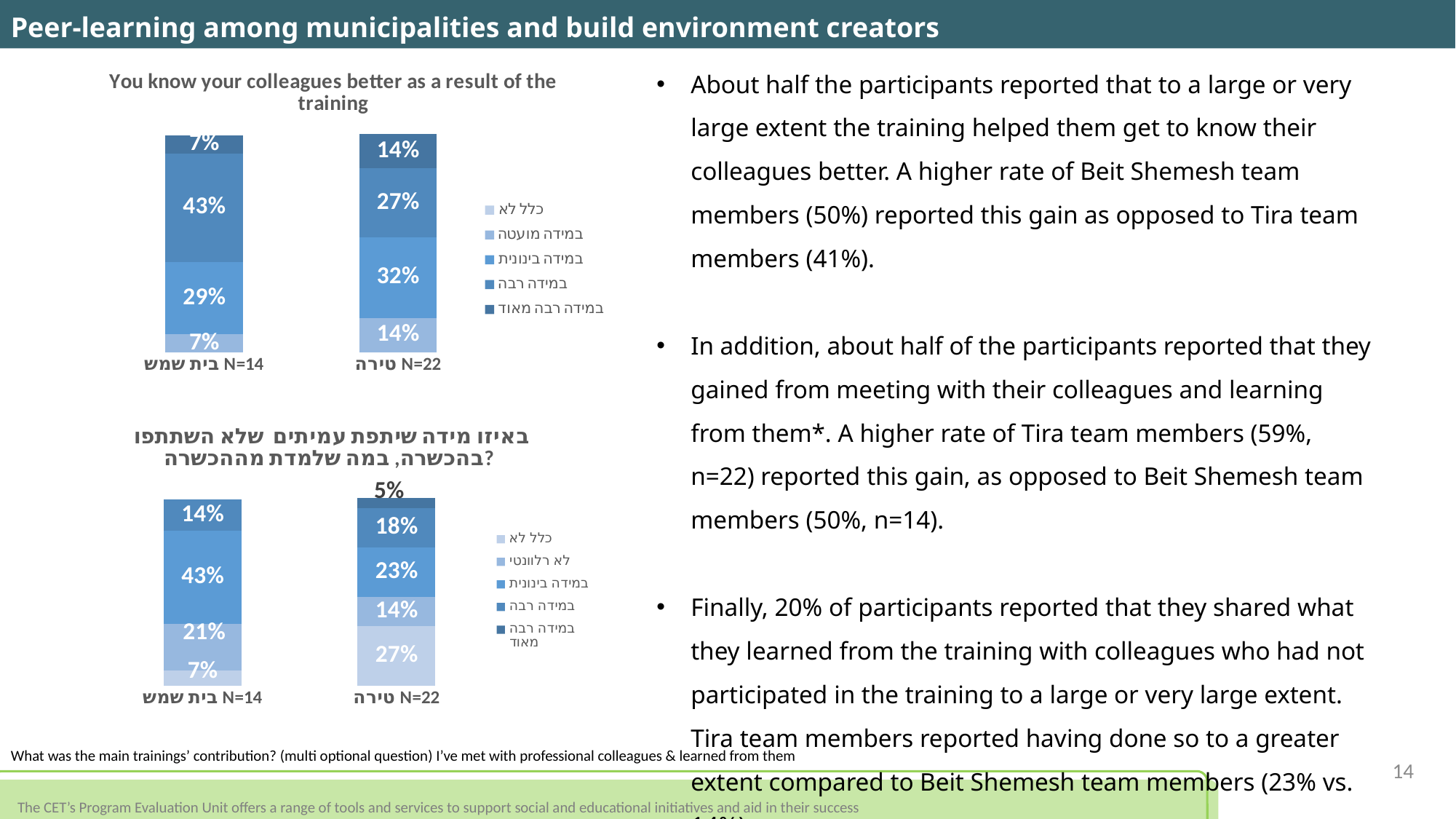
In the bottom chart (sharing what was learned with colleagues), what is the value of the topmost segment of the טירה bar? 5% In the bottom chart (sharing what was learned with colleagues), what is the value of the bottom segment of the טירה bar? 27% What type of chart is the top chart titled 'You know your colleagues better as a result of the training'? Stacked bar chart In the bottom chart (sharing what was learned with colleagues), what is the difference between the 43% segment and the 21% segment of the בית שמש bar? 22 percentage points In the bottom chart (sharing what was learned with colleagues), what sample size is shown for the טירה bar? N=22 In the top chart ('You know your colleagues better...'), what is the value of the bottom segment of the בית שמש bar? 7% In the top chart ('You know your colleagues better...'), what is the value of the largest segment in the בית שמש bar? 43% In the top chart ('You know your colleagues better...'), what is the value of the topmost segment of the טירה bar? 14% In the top chart ('You know your colleagues better...'), what is the difference between the 32% segment and the 27% segment of the טירה bar? 5 percentage points In the top chart ('You know your colleagues better...'), how many entries does the legend list? 5 In the top chart ('You know your colleagues better...'), which bar has the larger single segment: בית שמש (43%) or טירה (32%)? בית שמש In the top chart ('You know your colleagues better...'), how many bars (groups) are plotted? 2